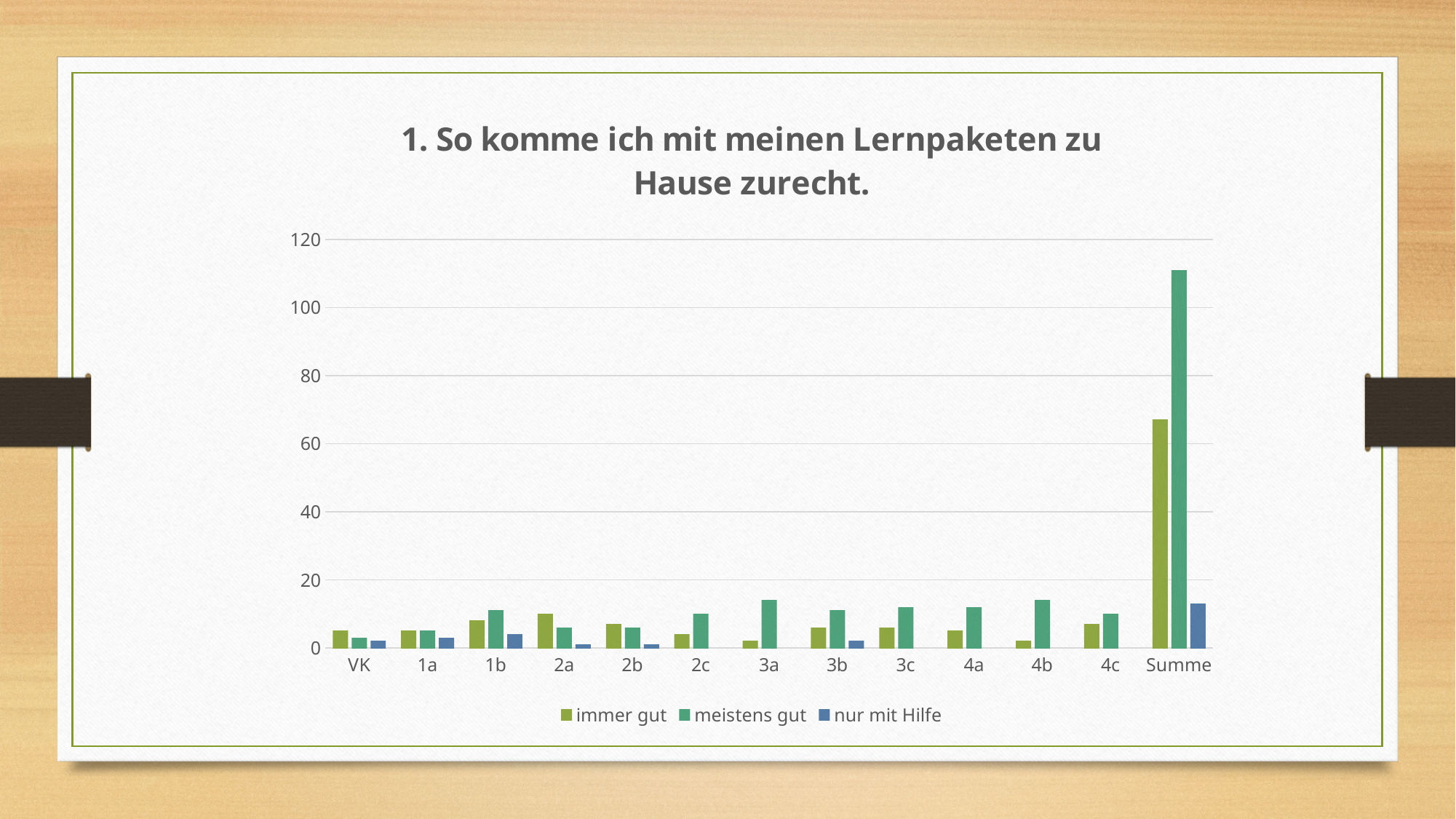
Is the value for immer gut in the Summe category greater or less than 80? less Is the value for immer gut in the Summe category greater or less than 60? greater Is the value for nur mit Hilfe in the Summe category greater or less than 20? less Which series has the highest bar in the Summe category? meistens gut Which series is shown in blue in the legend? nur mit Hilfe What kind of chart is shown on the slide? bar chart In the 3a category, which is larger: immer gut or meistens gut? meistens gut How many series does the legend list? 3 What is the title of the chart? 1. So komme ich mit meinen Lernpaketen zu Hause zurecht. How many categories are shown along the x axis? 13 In the Summe category, which is larger: immer gut or meistens gut? meistens gut